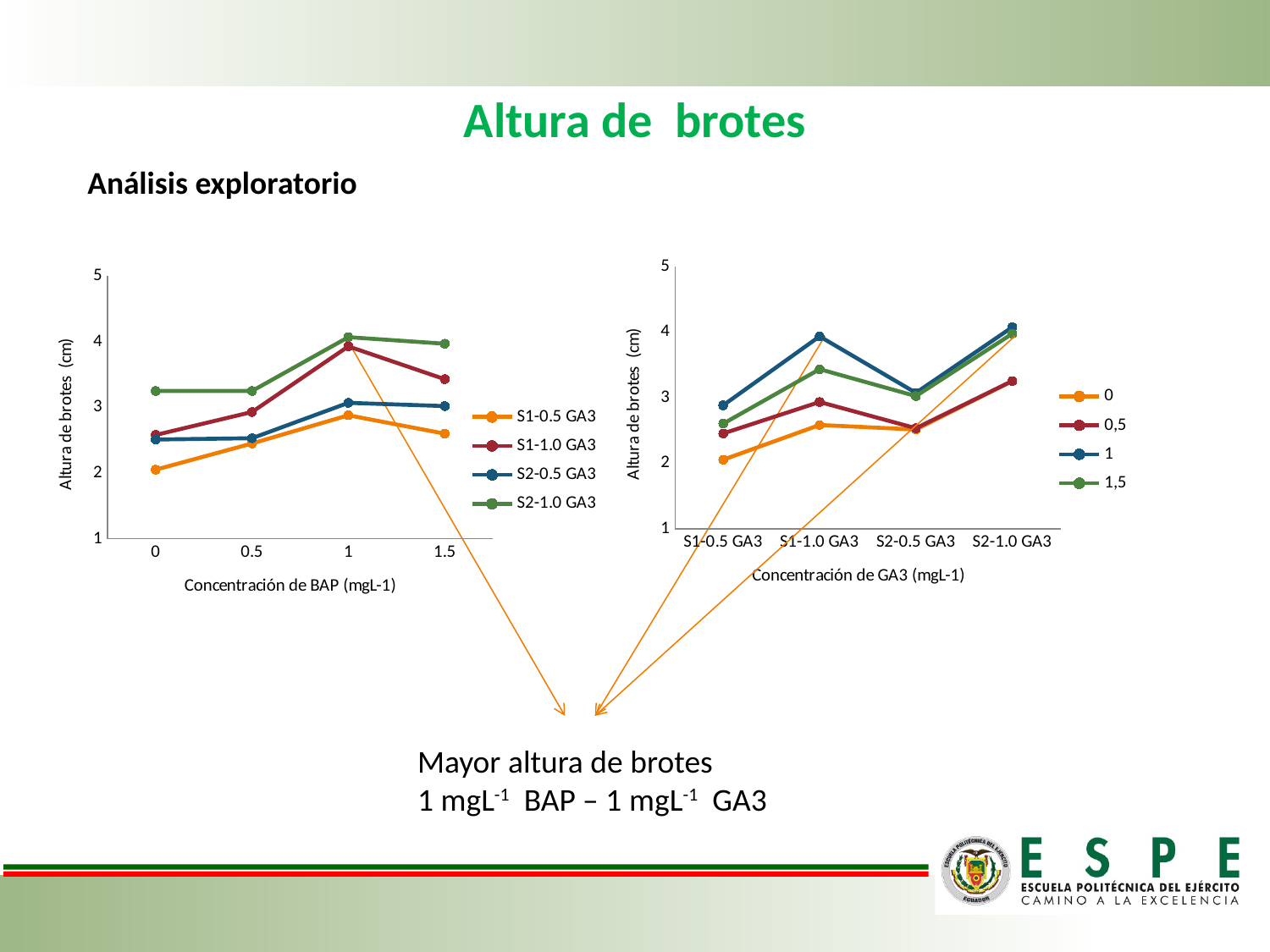
In the left chart (Concentración de BAP), does the S1-0.5 GA3 series rise or fall from BAP 0 to BAP 1? rise How many series does the legend of the right chart (Concentración de GA3) list? 4 In the left chart (Concentración de BAP), is the value for S2-1.0 GA3 at BAP 0 greater or less than 3? greater In the left chart (Concentración de BAP), which series has the highest value at BAP 0? S2-1.0 GA3 How many BAP concentration values are shown on the x axis of the left chart? 4 What is the y-axis label of the right chart? Altura de brotes (cm) In the left chart (Concentración de BAP), is the value for S1-0.5 GA3 at BAP 1.5 greater or less than 3? less In the right chart (Concentración de GA3), which series has the highest value at S1-1.0 GA3? 1 In the right chart (Concentración de GA3), is the value for series 0,5 at S2-1.0 GA3 greater or less than 3? greater How many series does the legend of the left chart (Concentración de BAP) list? 4 What kind of chart is the left chart (Concentración de BAP)? line chart In the left chart (Concentración de BAP), which series has the lowest value at BAP 0? S1-0.5 GA3